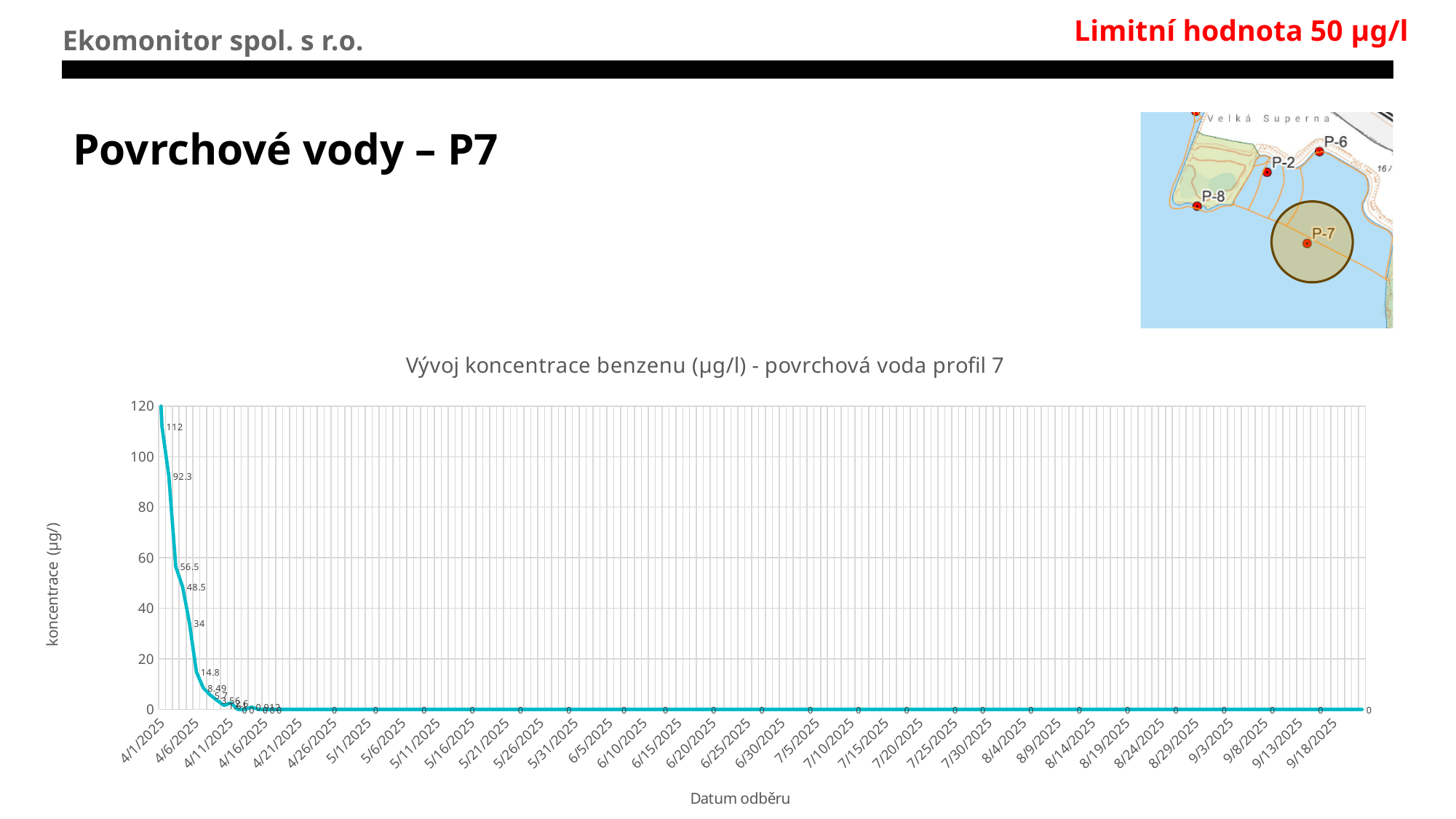
Do the values rise or fall along the x axis from 4/1/2025 onward? fall Is the value for 4/6/2025 greater or less than 80? less What is the value plotted for 7/5/2025? 0 Is the value for 4/1/2025 greater or less than 100? greater What is the label of the x axis of the chart? Datum odběru What is the title of the chart? Vývoj koncentrace benzenu (µg/l) - povrchová voda profil 7 What is the value plotted for 6/5/2025? 0 What type of chart is shown on the slide? line chart What is the highest tick value shown on the y axis? 120 Is the value for 4/11/2025 greater or less than 20? less Which is larger, the value for 4/1/2025 or the value for 4/16/2025? 4/1/2025 What is the value plotted for 9/18/2025? 0